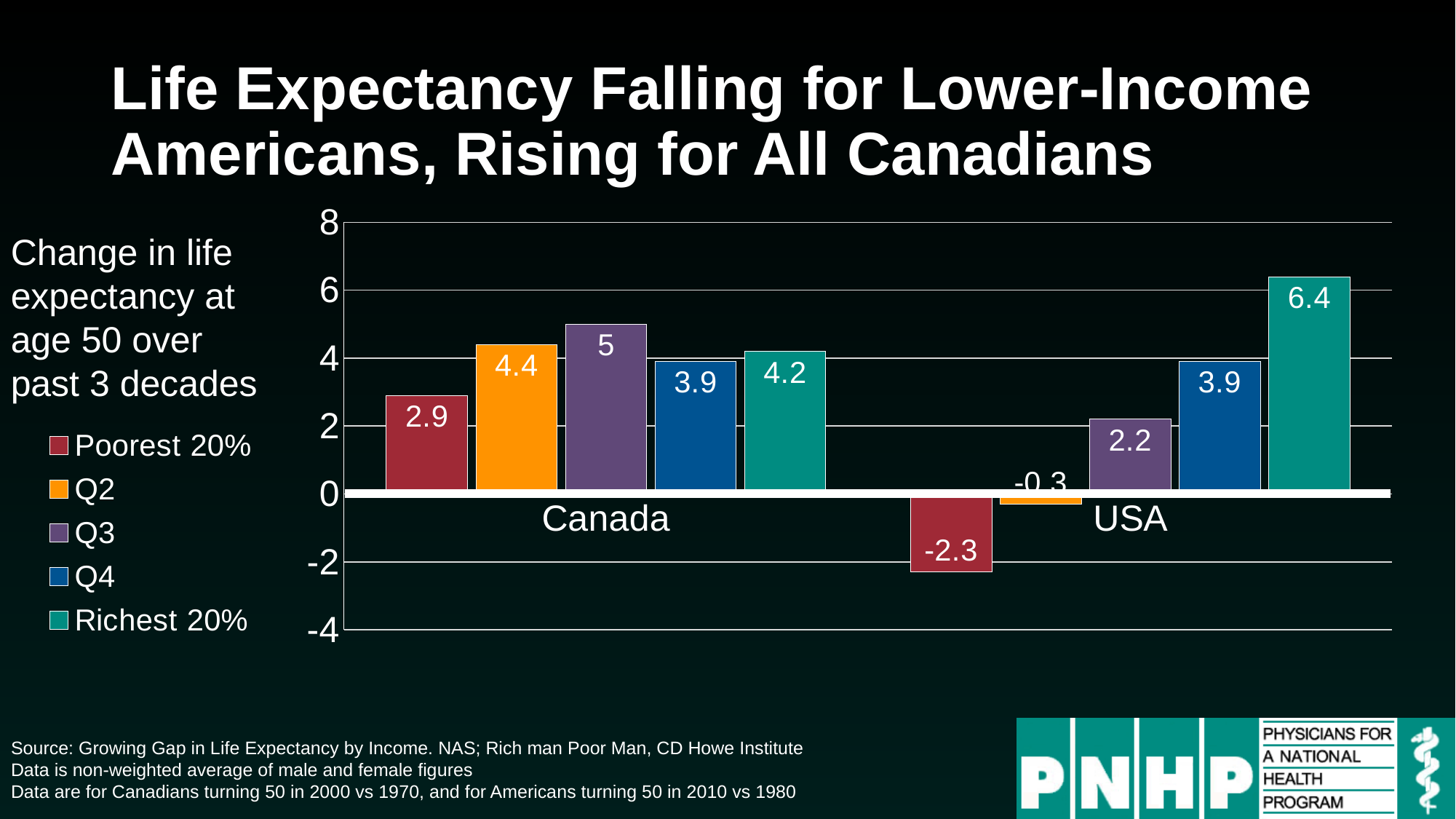
How many series does the legend list? 5 Which income group has the lowest value in the USA? Poorest 20% What is the difference between the Richest 20% and the Poorest 20% in the USA? 8.7 What kind of chart is shown on the slide? Bar chart What colour represents the Richest 20% in the chart? Teal What is the value for the Richest 20% in the USA? 6.4 Which is larger: the Q4 value for Canada or the Q4 value for the USA? They are equal (3.9) Which income group has the highest value in Canada? Q3 What is the value for the Poorest 20% in Canada? 2.9 What is the value for Q3 in Canada? 5 What is the value for Q2 in the USA? -0.3 Is the value for the Richest 20% in the USA greater or less than 6? greater